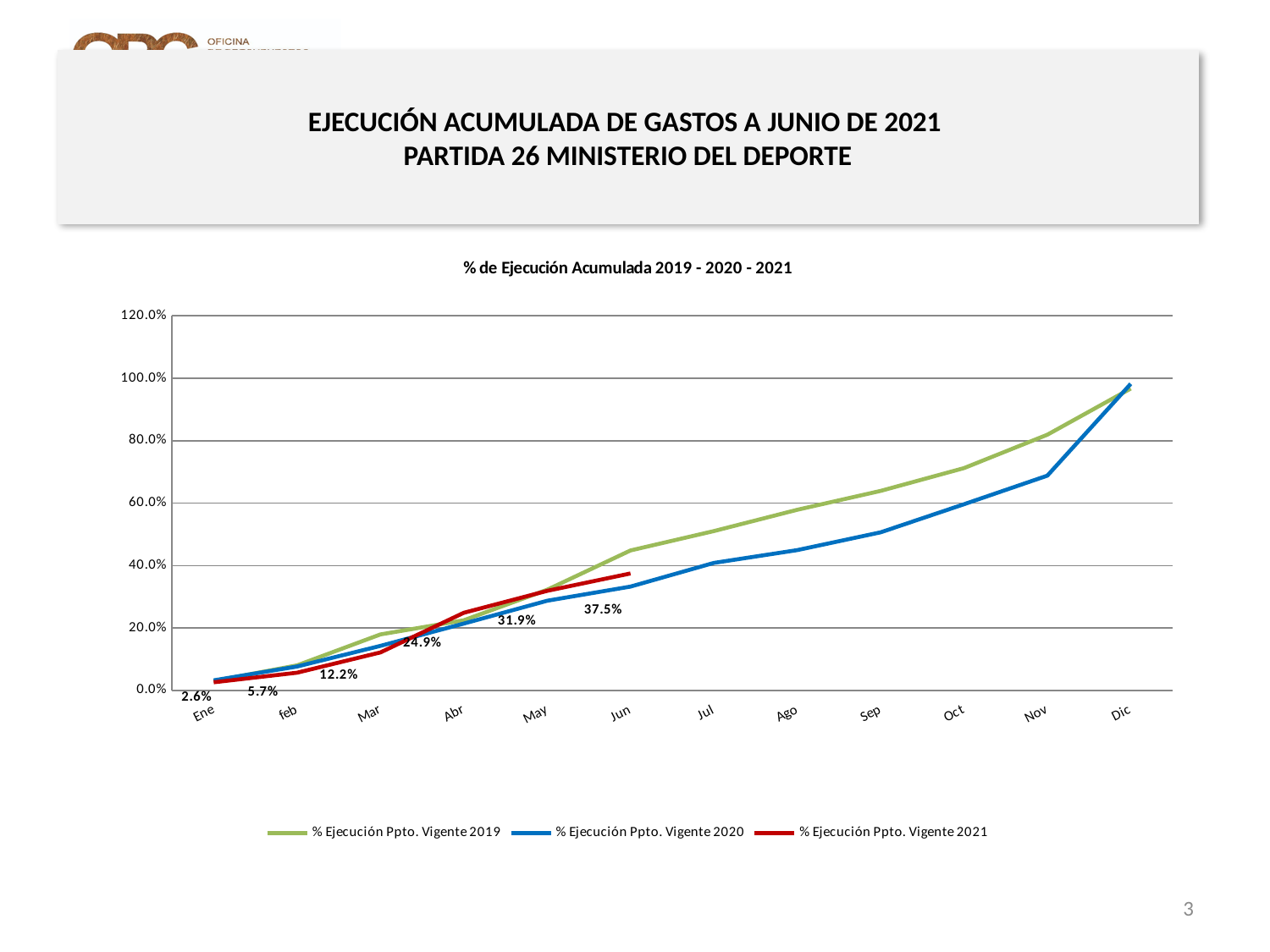
Does the % Ejecución Ppto. Vigente 2019 series rise or fall from Ene to Dic? rise How many series does the legend list? 3 What is the value of % Ejecución Ppto. Vigente 2021 in Jun? 37.5% What is the value of % Ejecución Ppto. Vigente 2021 in Ene? 2.6% Is the value for % Ejecución Ppto. Vigente 2020 in Nov greater or less than 80.0%? less Which month has the highest value for % Ejecución Ppto. Vigente 2021? Jun What is the value of % Ejecución Ppto. Vigente 2021 in Abr? 24.9% What is the chart's title? % de Ejecución Acumulada 2019 - 2020 - 2021 How many months are shown on the x axis? 12 What is the value of % Ejecución Ppto. Vigente 2021 in Mar? 12.2% What type of chart is shown on the slide? line chart What is the difference between the % Ejecución Ppto. Vigente 2021 values for Jun and May? 5.6%